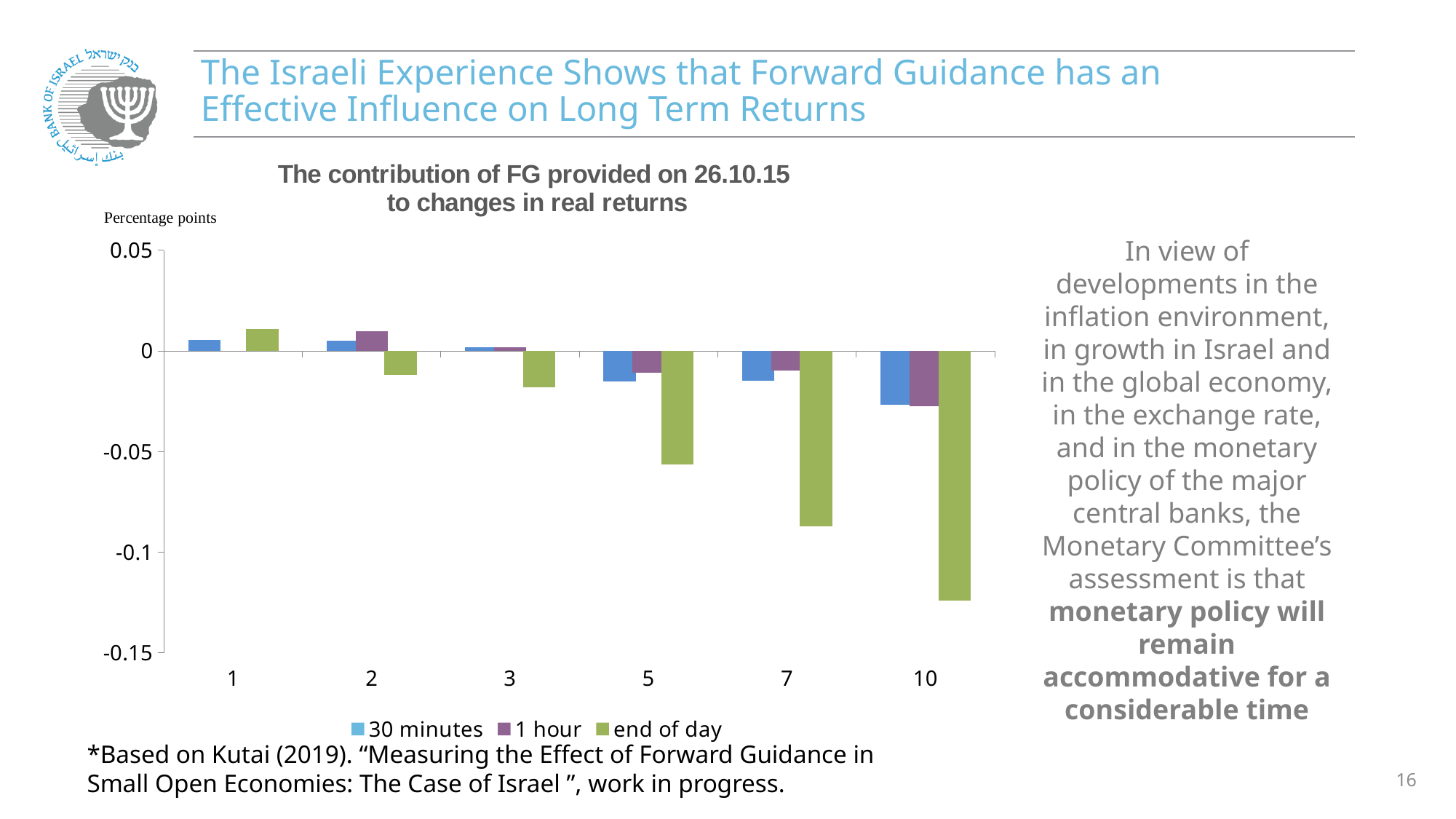
How many series does the chart's legend list? 3 What unit label is shown above the y axis of the chart? Percentage points Which category has the highest value for the 'end of day' series? 1 Which is larger, the 'end of day' value for category 7 or for category 10? category 7 Is the 'end of day' value for category 10 greater or less than -0.1? less Do the 'end of day' values rise or fall as you move from category 1 to category 10 along the x axis? fall What kind of chart is shown on the slide? bar chart What are the three series listed in the chart's legend? 30 minutes, 1 hour, end of day Is the 'end of day' value for category 7 greater or less than -0.1? greater Which category has the lowest value for the 'end of day' series? 10 Is the 'end of day' value for category 7 greater or less than -0.05? less How many categories are shown along the x axis of the chart? 6